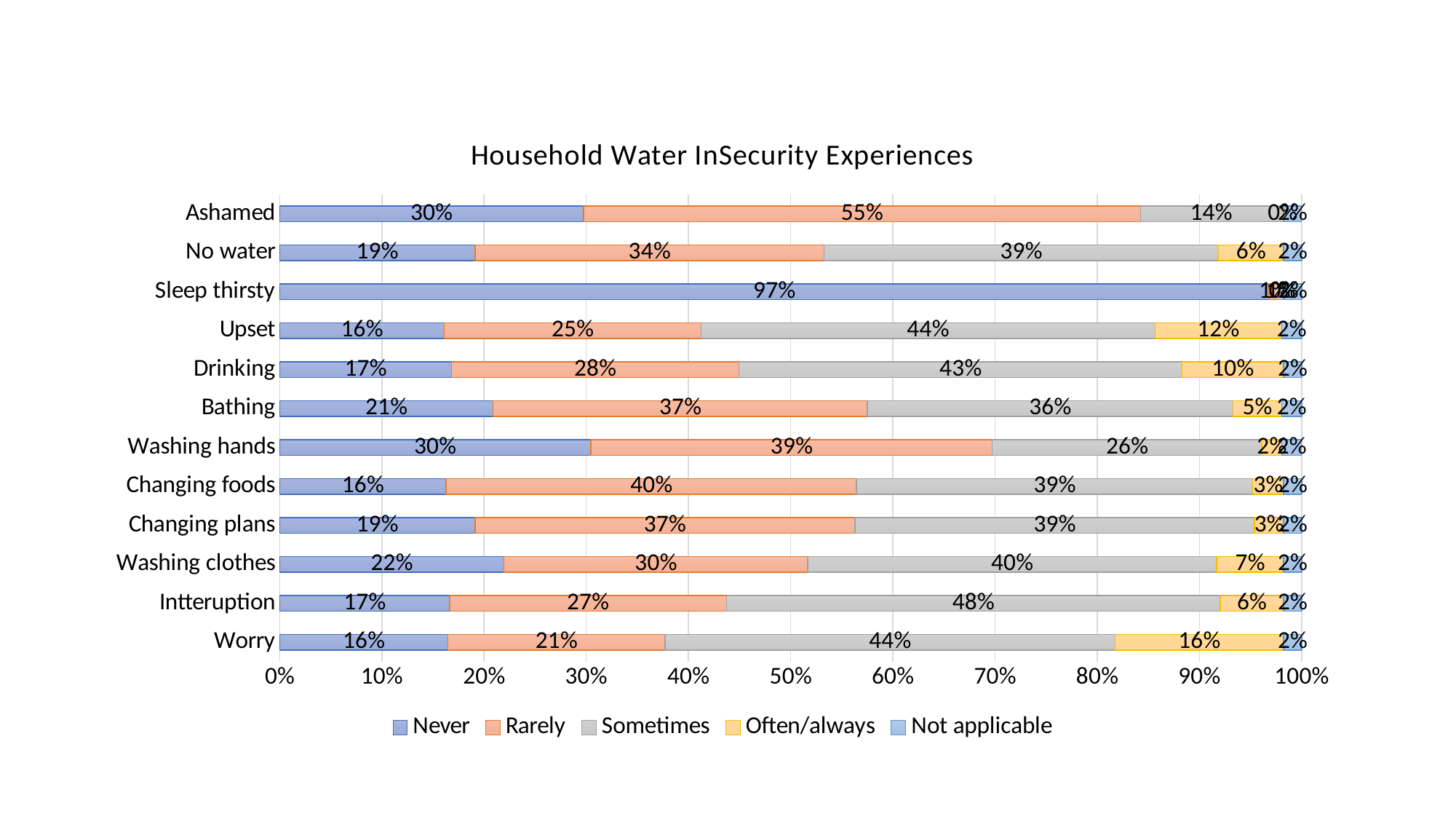
For Upset, what is the difference between the 'Sometimes' value and the 'Rarely' value? 19 percentage points What type of chart is shown on the slide? Stacked bar chart Which is larger: the 'Often/always' value for Drinking or for Washing clothes? Drinking What is the 'Rarely' value for Ashamed? 55% What is the 'Never' value for Sleep thirsty? 97% What is the 'Sometimes' value for Intteruption? 48% What is the 'Often/always' value for Worry? 16% How many series does the legend list? 5 How many categories are shown on the vertical axis? 12 Which category has the lowest 'Rarely' value? Sleep thirsty Which category has the highest 'Sometimes' value? Intteruption What is the title of the chart? Household Water InSecurity Experiences